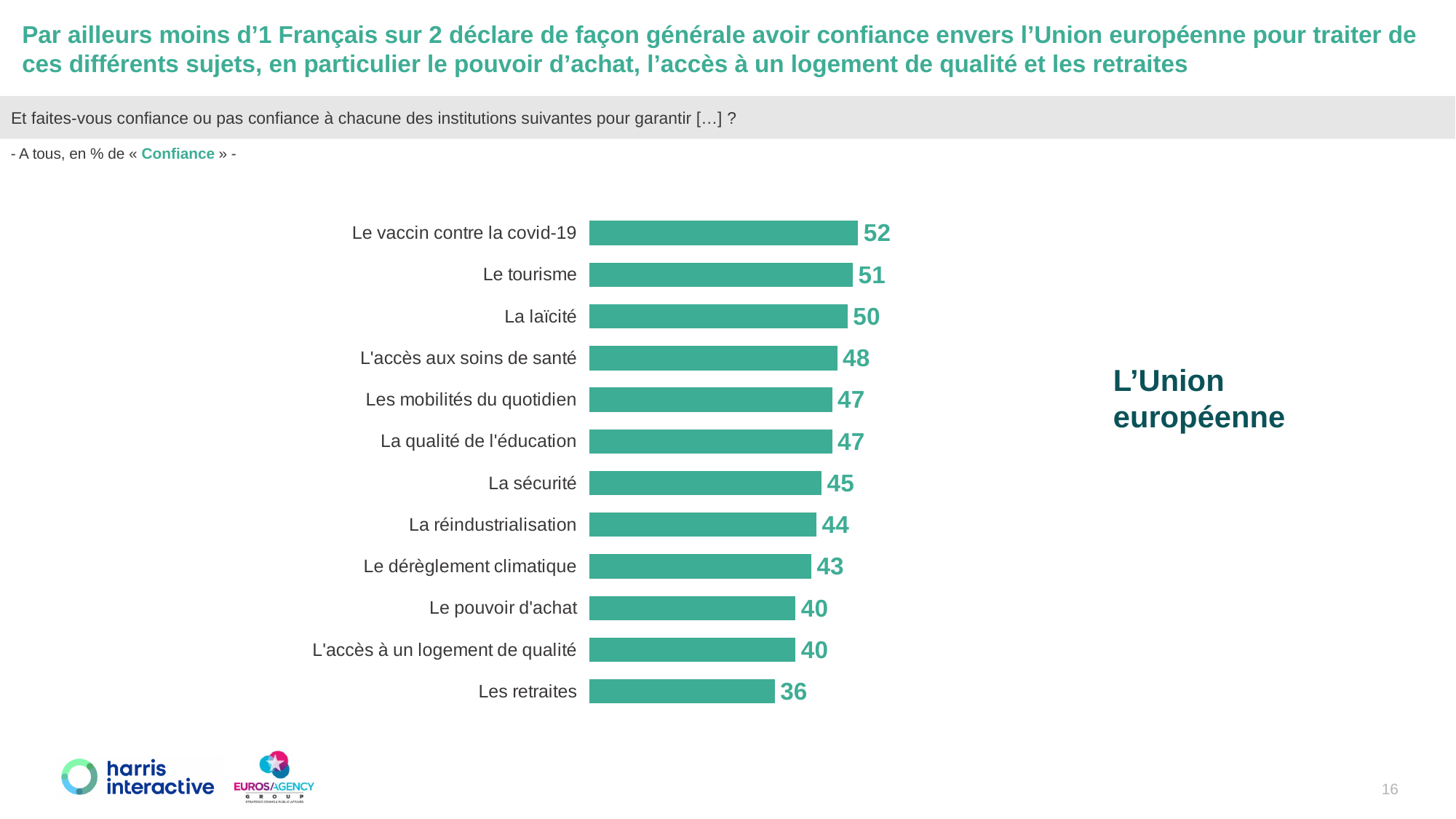
What is the value for "Le pouvoir d'achat"? 40 How many categories are shown in the chart? 12 What is the value for "La sécurité"? 45 What is the value for "Les retraites"? 36 Which category has the highest value? Le vaccin contre la covid-19 What is the value for "Le vaccin contre la covid-19"? 52 What kind of chart is shown on the slide? Bar chart Which institution does the chart refer to, according to the label next to it? L'Union européenne Which is larger, the value for "Le tourisme" or the value for "La réindustrialisation"? Le tourisme What is the difference between the values for "Le vaccin contre la covid-19" and "Les retraites"? 16 What is the difference between the values for "La laïcité" and "Le dérèglement climatique"? 7 Which category has the lowest value? Les retraites